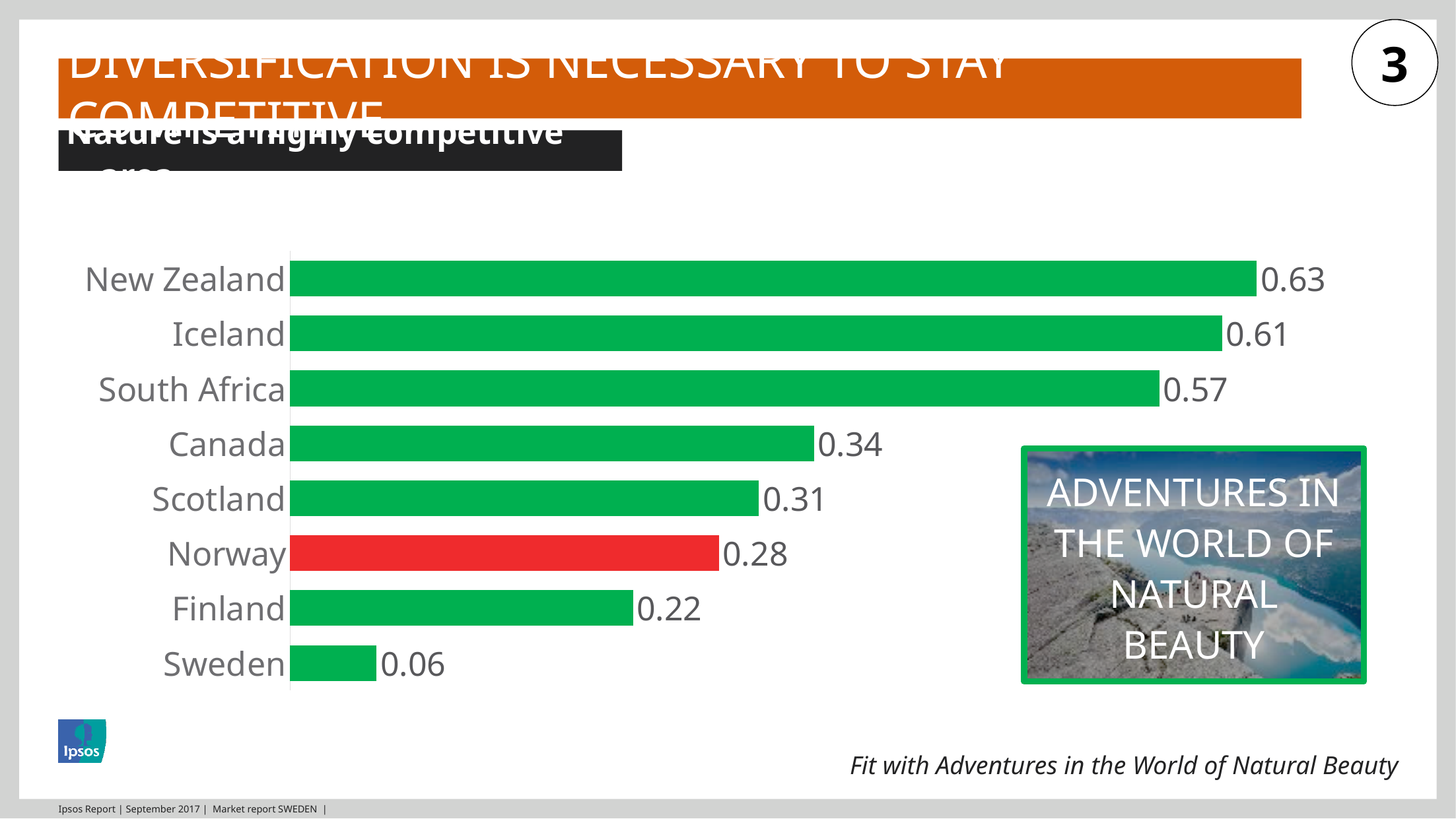
Which has a larger value, Finland or Norway? Norway Which country's bar is coloured red instead of green? Norway Which country has the highest value? New Zealand What is the difference between the values for Canada and Scotland? 0.03 What is the value for New Zealand? 0.63 What is the value for South Africa? 0.57 What is the value for Norway? 0.28 How many countries are shown in the chart? 8 What is the difference between the values for New Zealand and Sweden? 0.57 What is the value for Sweden? 0.06 What type of chart is shown? Bar chart Which country has the lowest value? Sweden